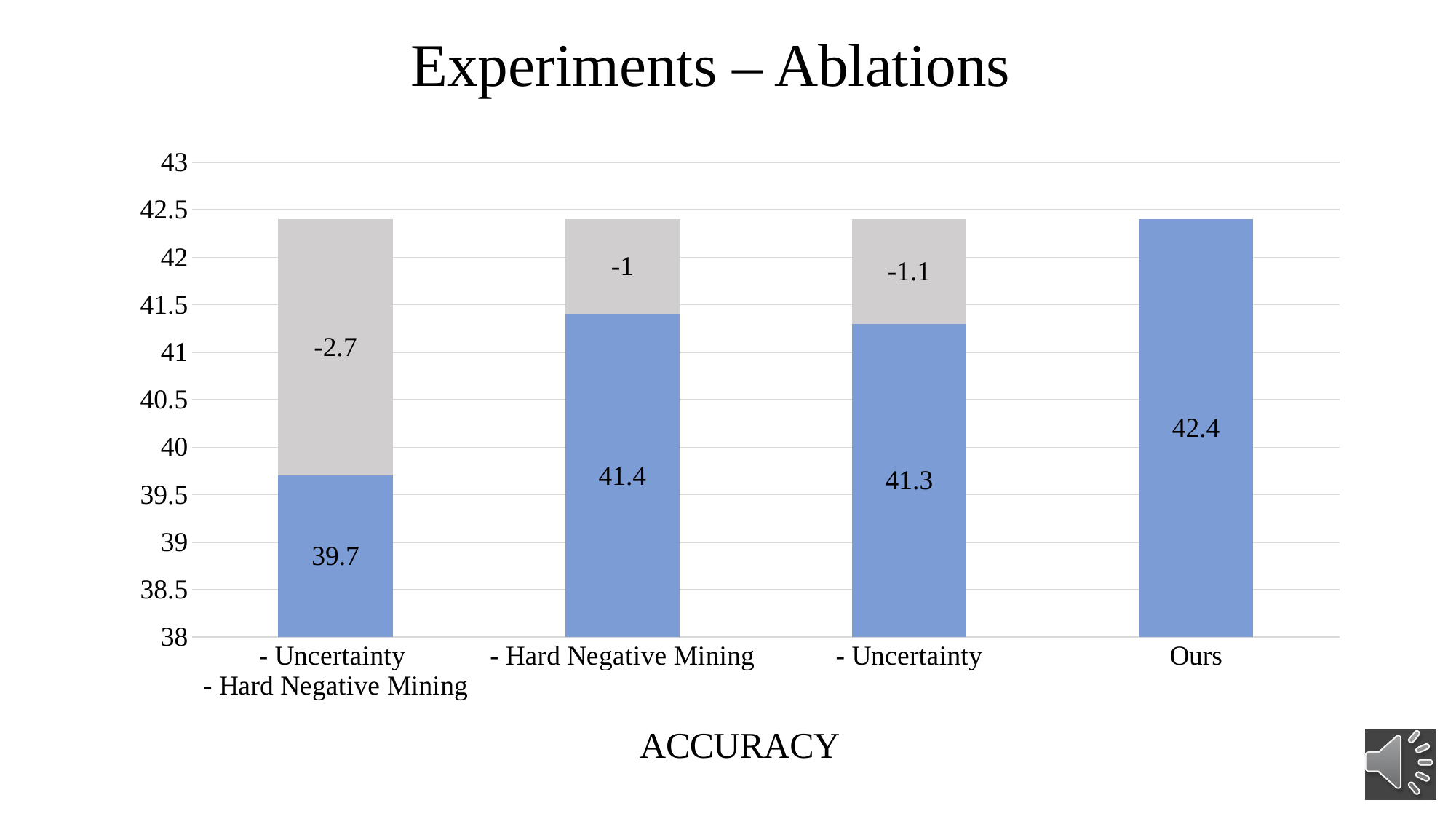
What drop value is printed in the grey segment above the "- Hard Negative Mining" bar? -1 What is the accuracy value shown for the "- Hard Negative Mining" bar? 41.4 What is the accuracy value shown for the bar labelled "- Uncertainty - Hard Negative Mining"? 39.7 Which category has the lowest accuracy value? - Uncertainty - Hard Negative Mining What drop value is printed in the grey segment above the "- Uncertainty - Hard Negative Mining" bar? -2.7 What is the difference between the accuracy of "Ours" and the accuracy of "- Uncertainty - Hard Negative Mining"? 2.7 What kind of chart is shown on the slide? Bar chart How many categories are shown on the x axis? 4 What is the accuracy value shown for the "- Uncertainty" bar? 41.3 What is the accuracy value shown for the "Ours" bar? 42.4 What is the title printed below the chart's x axis? ACCURACY Which category has the highest accuracy value? Ours